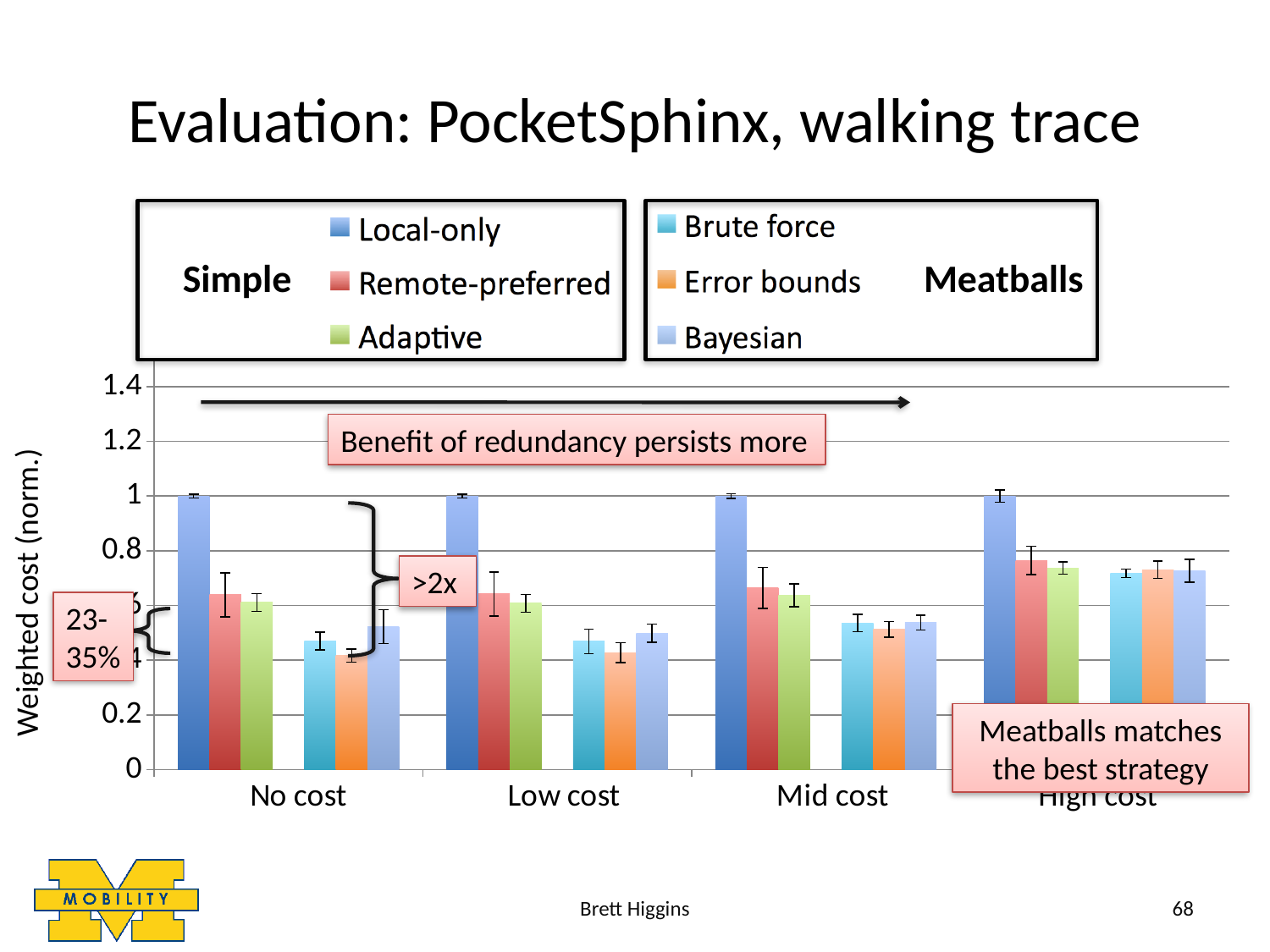
Is the value for Adaptive in the Mid cost category greater or less than 0.8? less What kind of chart is shown on the slide? bar chart Which series has the highest weighted cost in the High cost category? Local-only In the Mid cost category, which is larger: Local-only or Error bounds? Local-only Which series has the lowest weighted cost in the No cost category? Error bounds How many cost categories are shown on the x axis? 4 Is the value for Brute force in the No cost category greater or less than 0.6? less Do the Error bounds values rise or fall from No cost to High cost? rise What is the label on the y axis? Weighted cost (norm.) Is the value for Remote-preferred in the High cost category greater or less than 0.6? greater What is the weighted cost for Local-only in the No cost category? 1 How many series do the legends list in total? 6